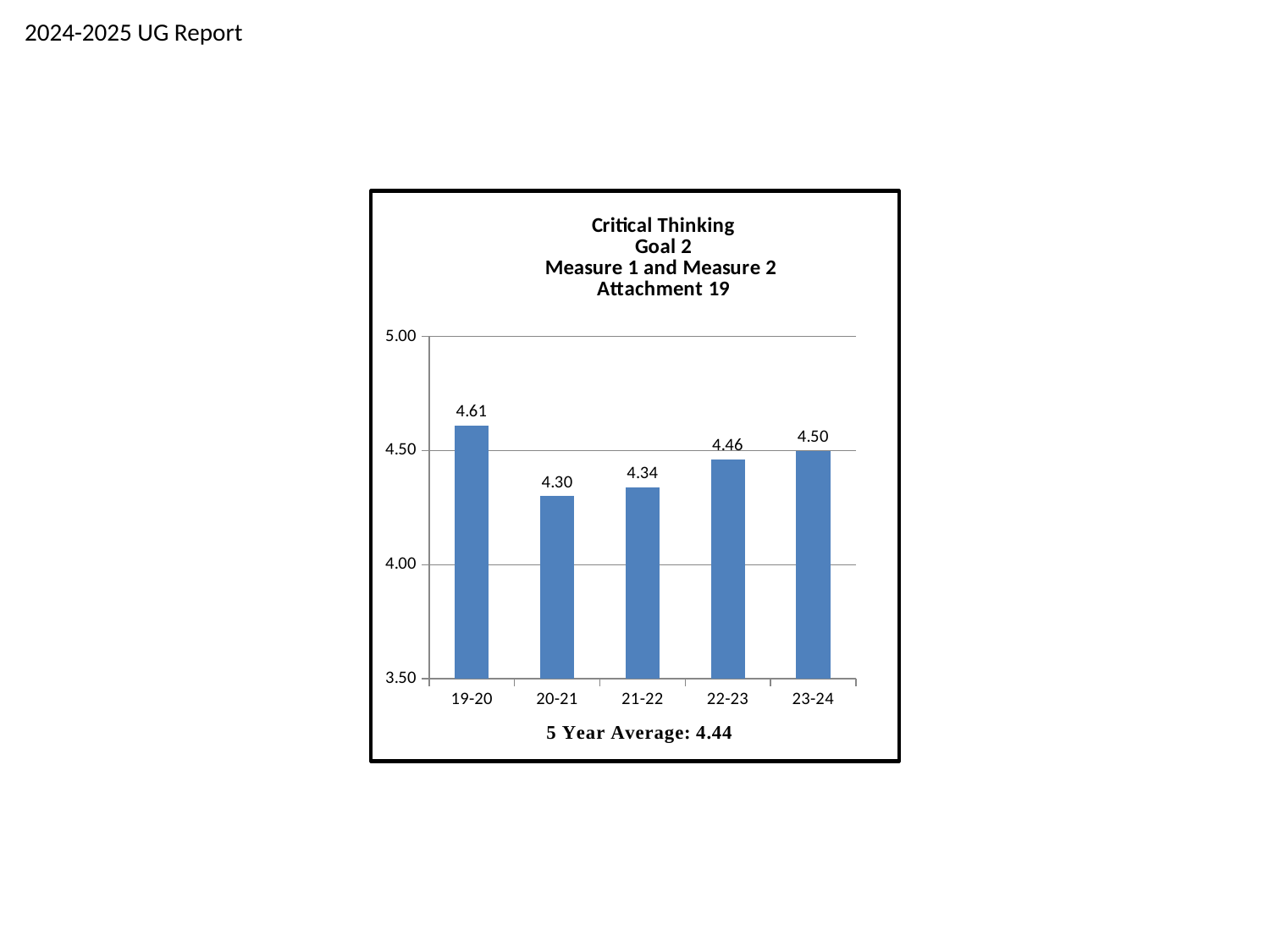
How many years are shown on the x axis? 5 What is the value for 23-24? 4.50 What 5 year average is stated below the chart? 4.44 What is the difference between the values for 23-24 and 22-23? 0.04 What kind of chart is this? bar chart What is the value for 19-20? 4.61 What is the value for 20-21? 4.30 Which year has the lowest value? 20-21 Which is larger, the value for 21-22 or the value for 22-23? 22-23 Which year has the highest value? 19-20 What is the difference between the values for 19-20 and 20-21? 0.31 Is the value for 20-21 greater or less than 4.50? less